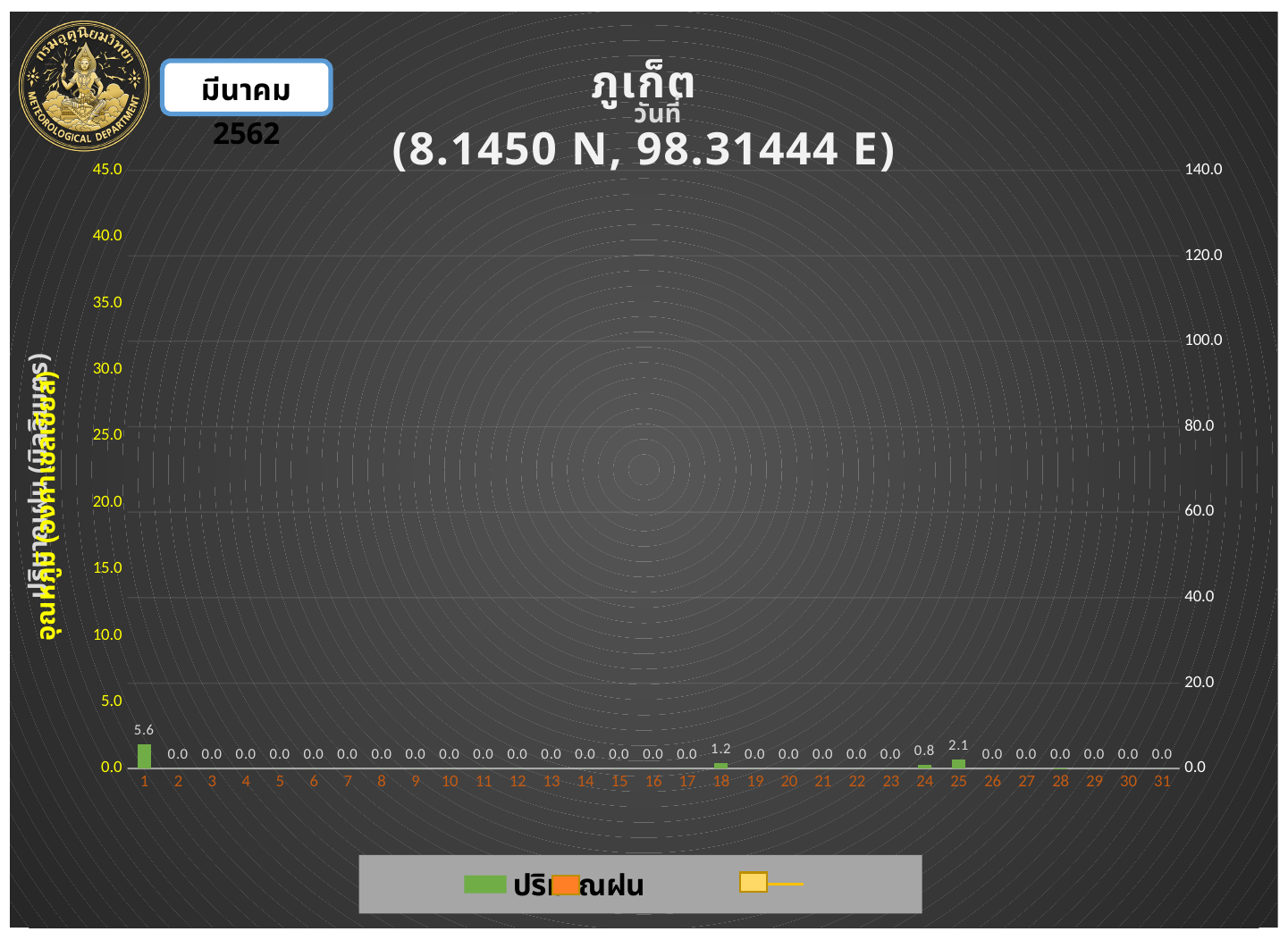
What is the difference between the rainfall values for day 25 and day 18? 0.9 What kind of chart is used to show the rainfall values? bar chart What is the difference between the rainfall values for day 1 and day 25? 3.5 What is the rainfall value shown for day 18? 1.2 What is the rainfall value shown for day 24? 0.8 How many days are shown on the x axis of the chart? 31 Which day has the larger rainfall value, day 18 or day 25? 25 Which day has the highest rainfall value? 1 What is the rainfall value shown for day 25? 2.1 What is the rainfall value shown for day 1? 5.6 Is the rainfall value for day 1 greater or less than 5.0? greater What is the rainfall value shown for day 10? 0.0